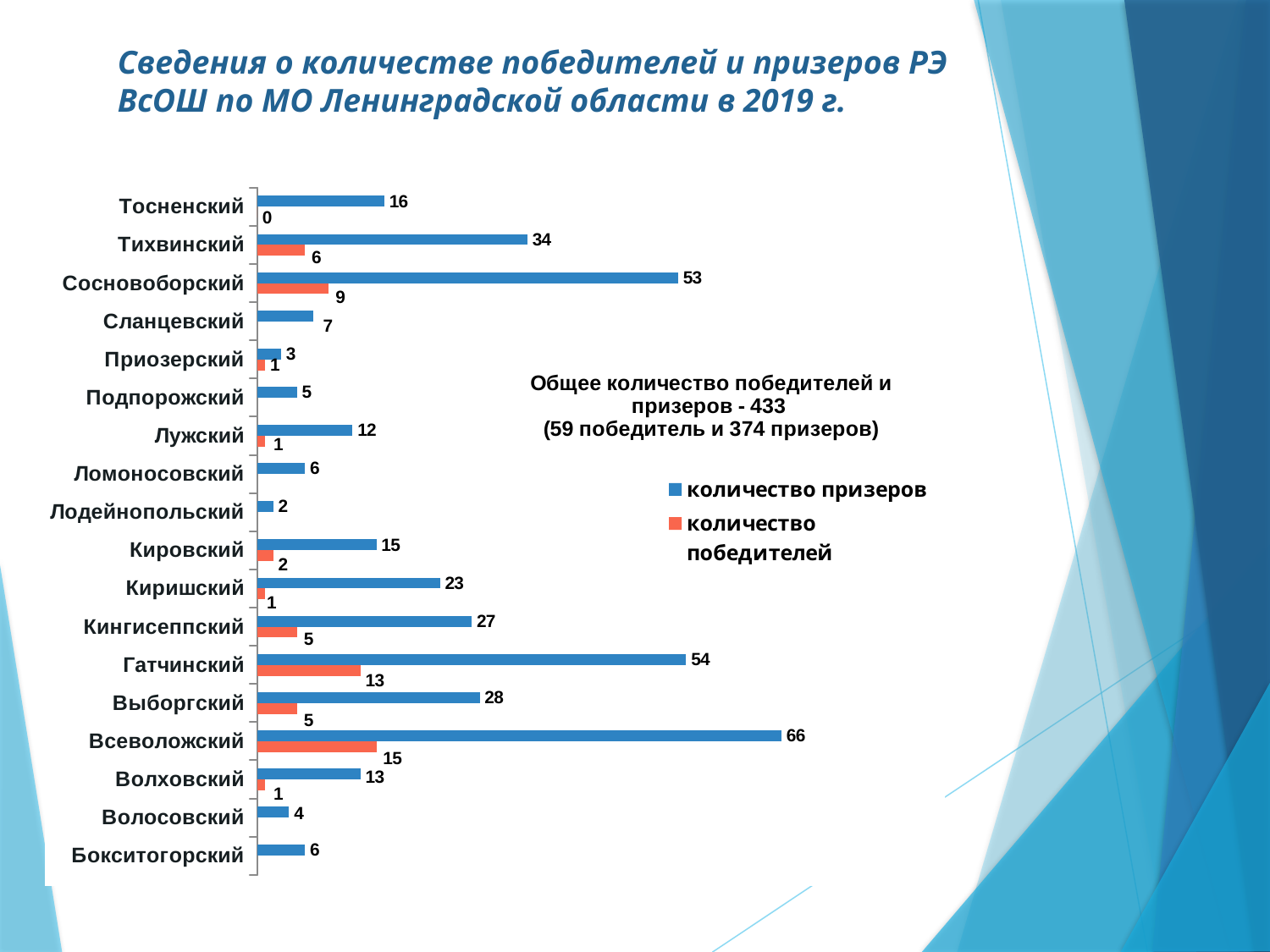
What kind of chart is shown on the slide? Bar chart Which district has the lowest number of призеров? Лодейнопольский What is the difference between the number of призеров for Гатчинский and Выборгский? 26 How many series does the legend list? 2 How many districts are shown on the chart? 18 What is the number of призеров (prize-winners) for Всеволожский? 66 What is the number of победителей for Тосненский? 0 What is the number of победителей (winners) for Гатчинский? 13 Which colour represents количество победителей in the legend? Orange Which has more призеров, Тихвинский or Кингисеппский? Тихвинский Which district has the highest number of призеров? Всеволожский What is the number of призеров for Сосновоборский? 53